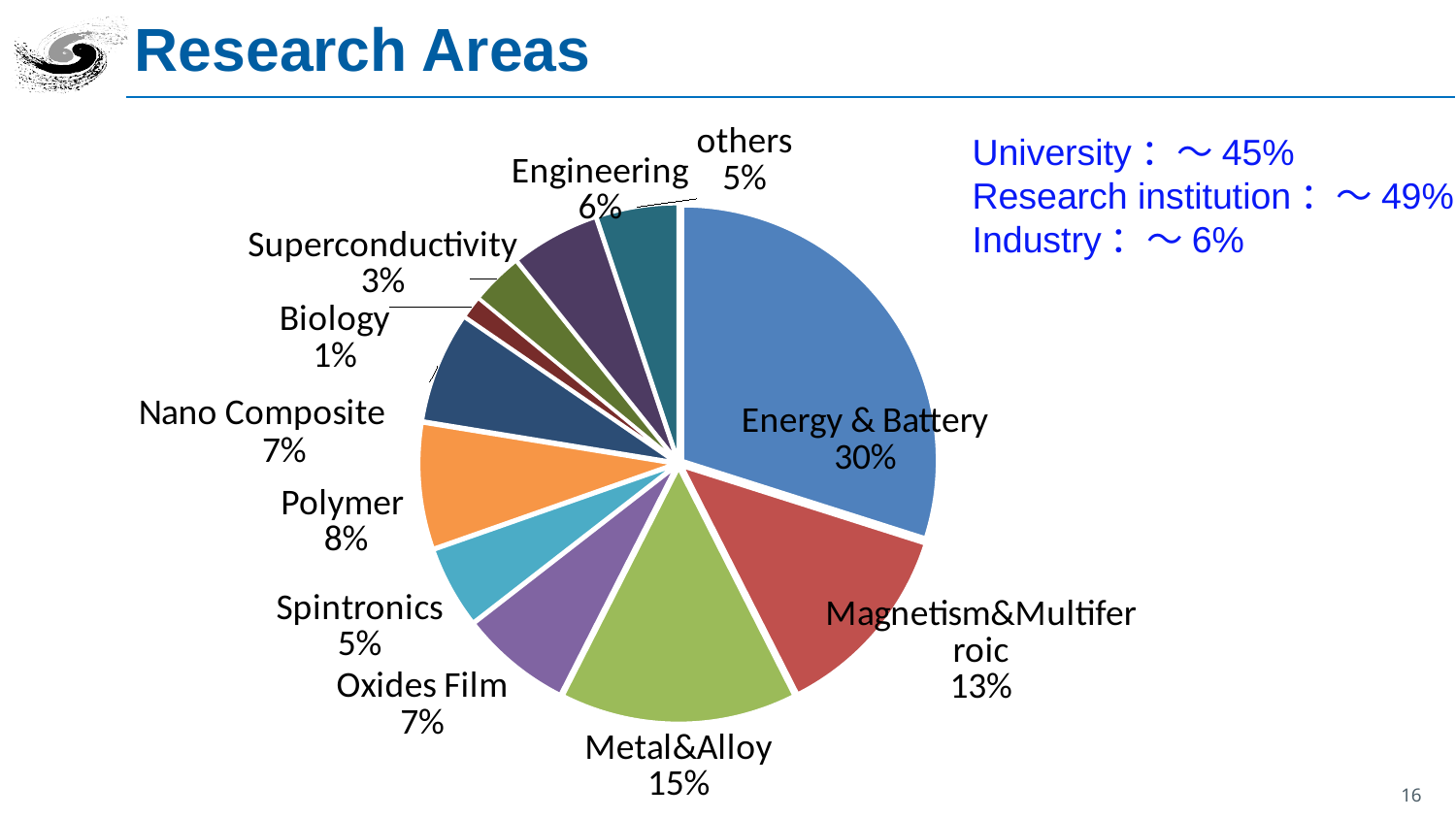
Which research area has the smallest slice of the pie? Biology What kind of chart is shown on the slide? Pie chart What is the difference in percentage points between Energy & Battery and Magnetism&Multiferroic? 17 Which is larger, the share for Polymer or the share for Spintronics? Polymer What is the combined share of Oxides Film and Nano Composite? 14% What percentage is shown for Superconductivity? 3% What share of the pie does Energy & Battery hold? 30% What percentage is shown for Metal&Alloy? 15% Which research area has the largest slice of the pie? Energy & Battery What percentage is shown for Polymer? 8% What is the title of the slide containing the chart? Research Areas How many slices does the pie chart have? 11